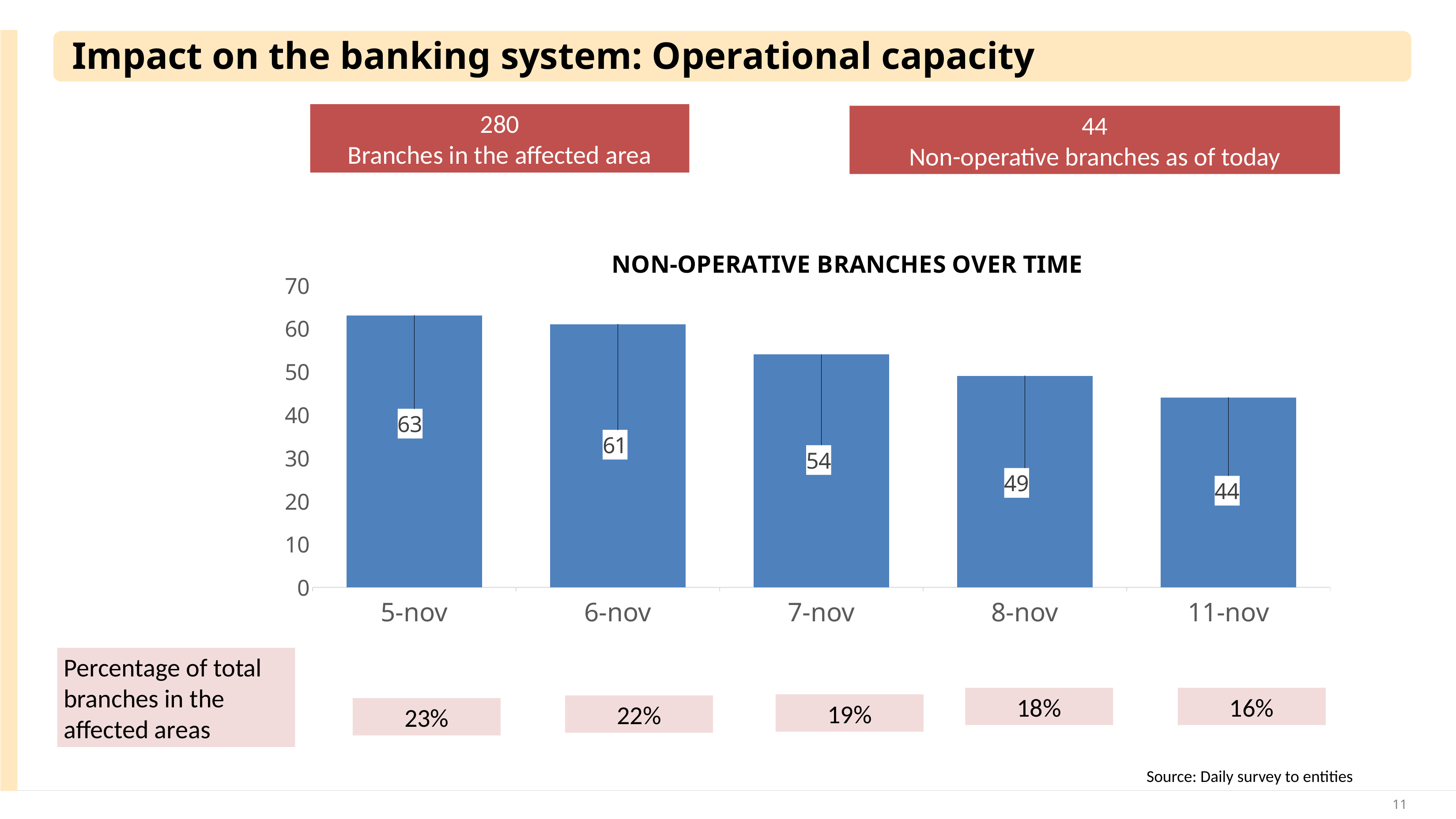
What is the number of non-operative branches on 7-nov? 54 How many dates are shown on the x axis of the chart? 5 Do the values rise or fall from 5-nov to 11-nov? fall Which date has more non-operative branches, 6-nov or 8-nov? 6-nov What is the difference between the number of non-operative branches on 5-nov and on 11-nov? 19 Which date has the highest number of non-operative branches? 5-nov Which date has the lowest number of non-operative branches? 11-nov What kind of chart is shown on the slide? bar chart What is the number of non-operative branches on 5-nov? 63 Is the value for 8-nov greater or less than 60? less What is the difference between the number of non-operative branches on 6-nov and on 8-nov? 12 What is the number of non-operative branches on 11-nov? 44